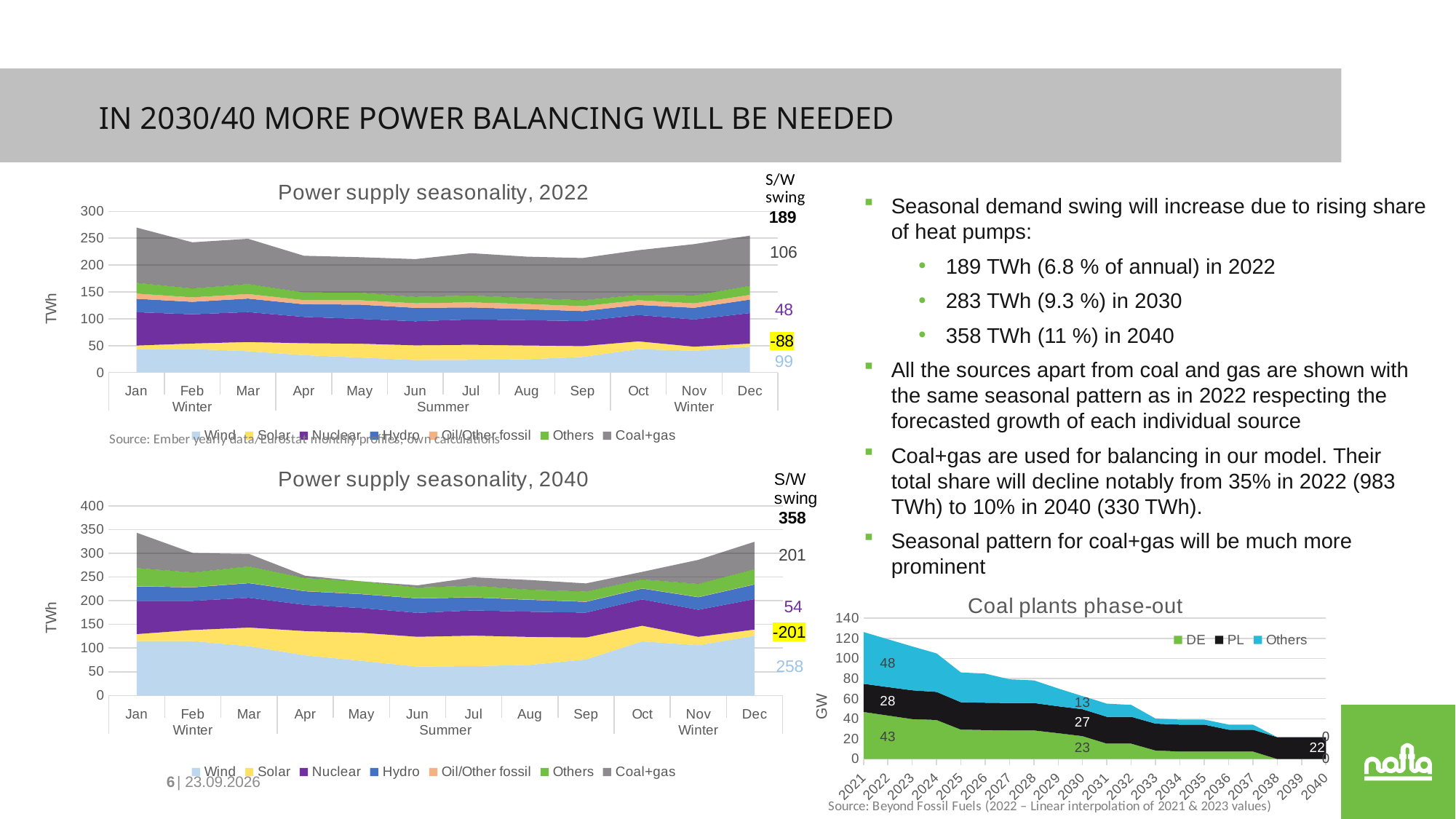
In 'Power supply seasonality, 2040', what is the total S/W swing shown in bold? 358 How many months are shown on the x axis of 'Power supply seasonality, 2022'? 12 What kind of chart is 'Power supply seasonality, 2022'? Stacked area chart In 'Power supply seasonality, 2022', what is the total S/W swing shown in bold? 189 How many series does the legend of 'Power supply seasonality, 2040' list? 7 In 'Coal plants phase-out', what is the PL value in 2030? 27 In 'Power supply seasonality, 2040', is the total supply in Jan greater or less than 300 TWh? greater In 'Coal plants phase-out', which series has the largest value in 2021? Others How many series does the legend of 'Coal plants phase-out' list? 3